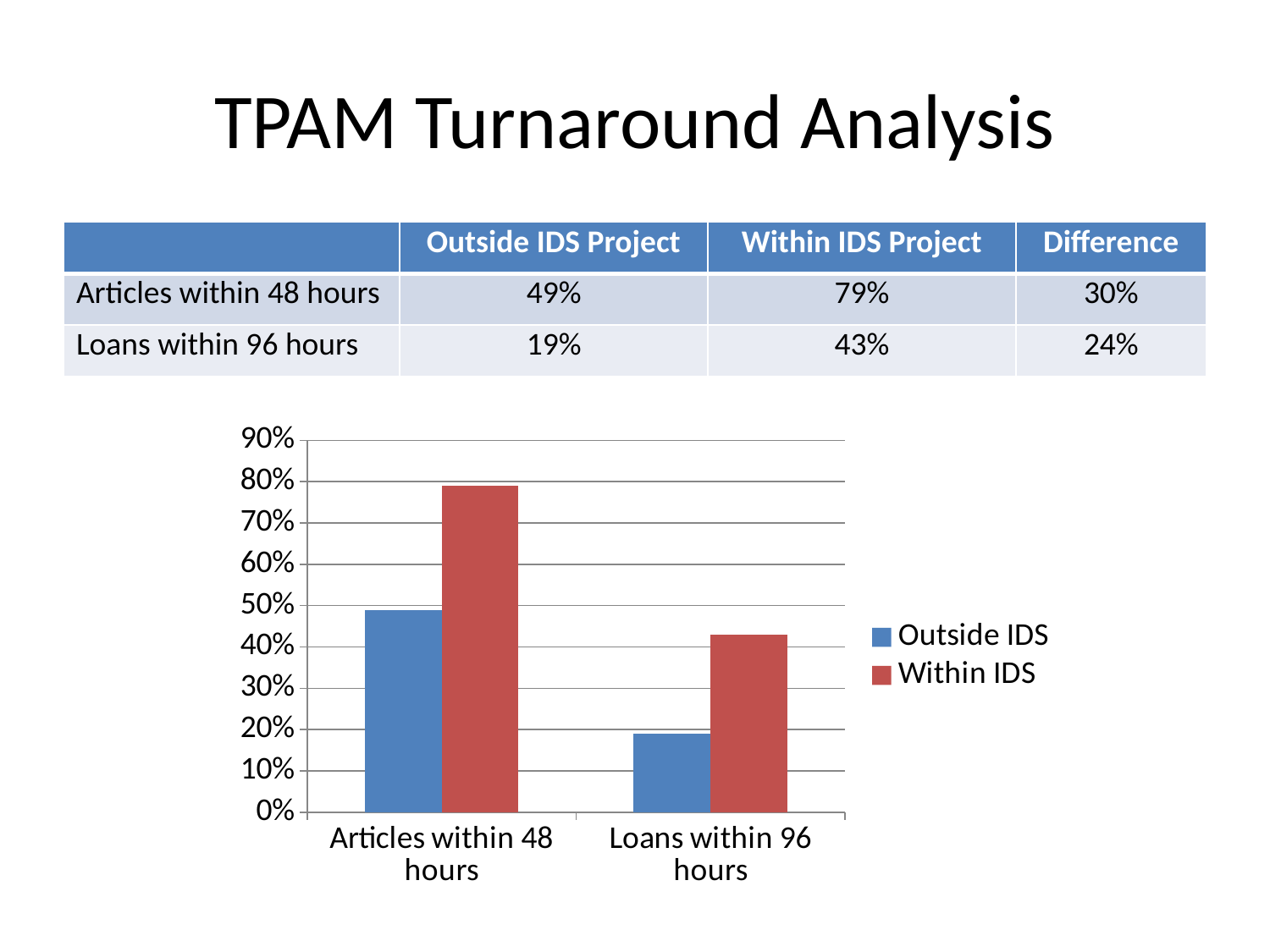
What is the Within IDS value for Articles within 48 hours? 79% Which colour represents the Within IDS series in the chart? red How many categories are shown on the x axis of the chart? 2 Which category has the lowest Outside IDS value? Loans within 96 hours What is the Outside IDS value for Loans within 96 hours? 19% Which category has the highest Within IDS value? Articles within 48 hours What is the Outside IDS value for Articles within 48 hours? 49% What kind of chart is shown on the slide? bar chart What is the difference between the Within IDS and Outside IDS values for Articles within 48 hours? 30% Is the Within IDS value for Loans within 96 hours greater or less than 40%? greater How many series does the chart legend list? 2 Which is larger for Loans within 96 hours, the Outside IDS bar or the Within IDS bar? Within IDS